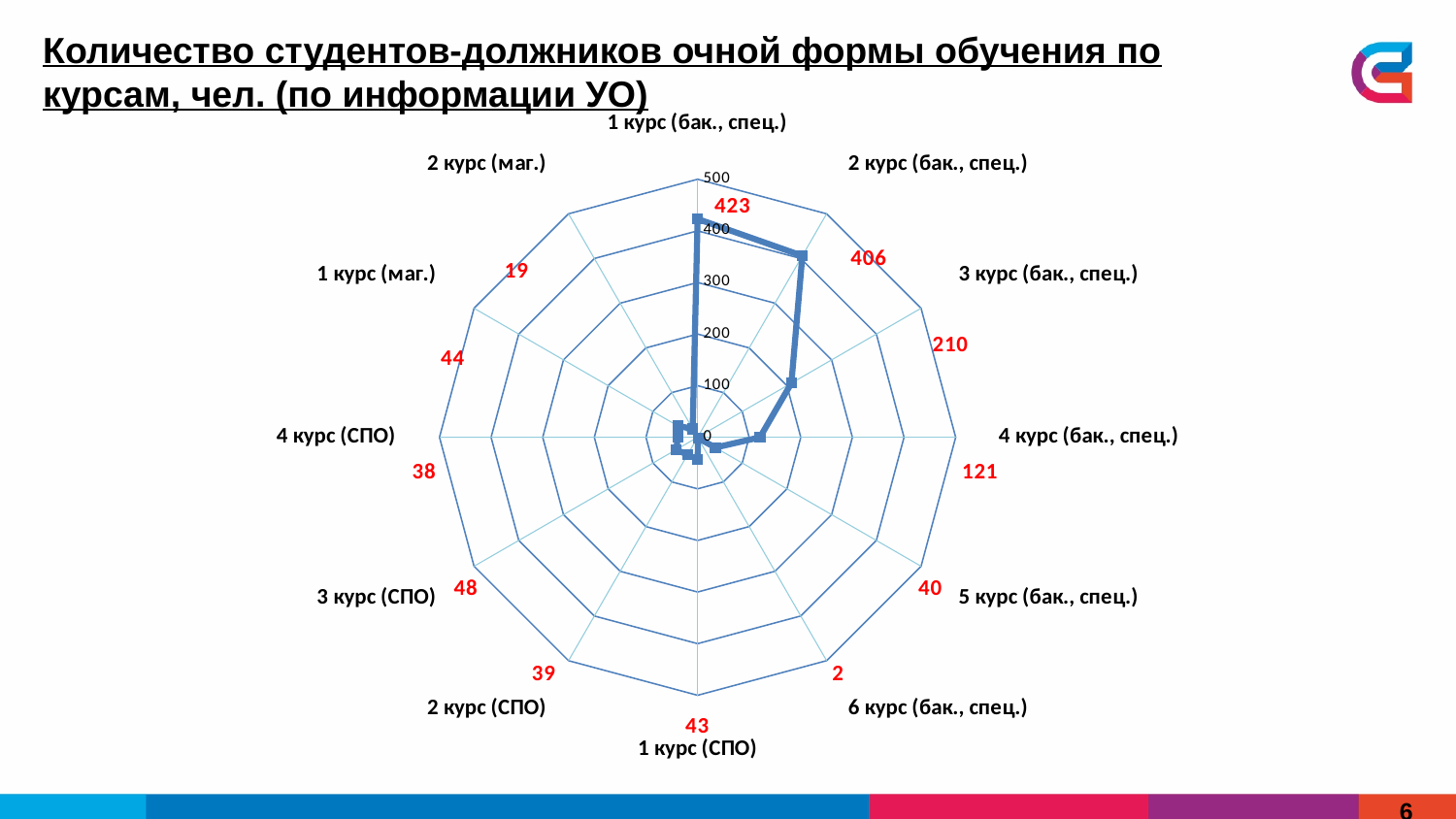
How many categories are plotted on the chart? 12 What is the value for 2 курс (маг.)? 19 Which category has the highest value? 1 курс (бак., спец.) What is the value for 1 курс (бак., спец.)? 423 What type of chart is shown on the slide? Radar chart What is the value for 4 курс (СПО)? 38 Which is larger: the value for 3 курс (СПО) or the value for 1 курс (маг.)? 3 курс (СПО) What is the value for 3 курс (бак., спец.)? 210 What is the difference between the values for 3 курс (бак., спец.) and 4 курс (бак., спец.)? 89 What is the maximum value shown on the chart's radial axis? 500 Which category has the lowest value? 6 курс (бак., спец.) What is the difference between the values for 1 курс (бак., спец.) and 2 курс (бак., спец.)? 17